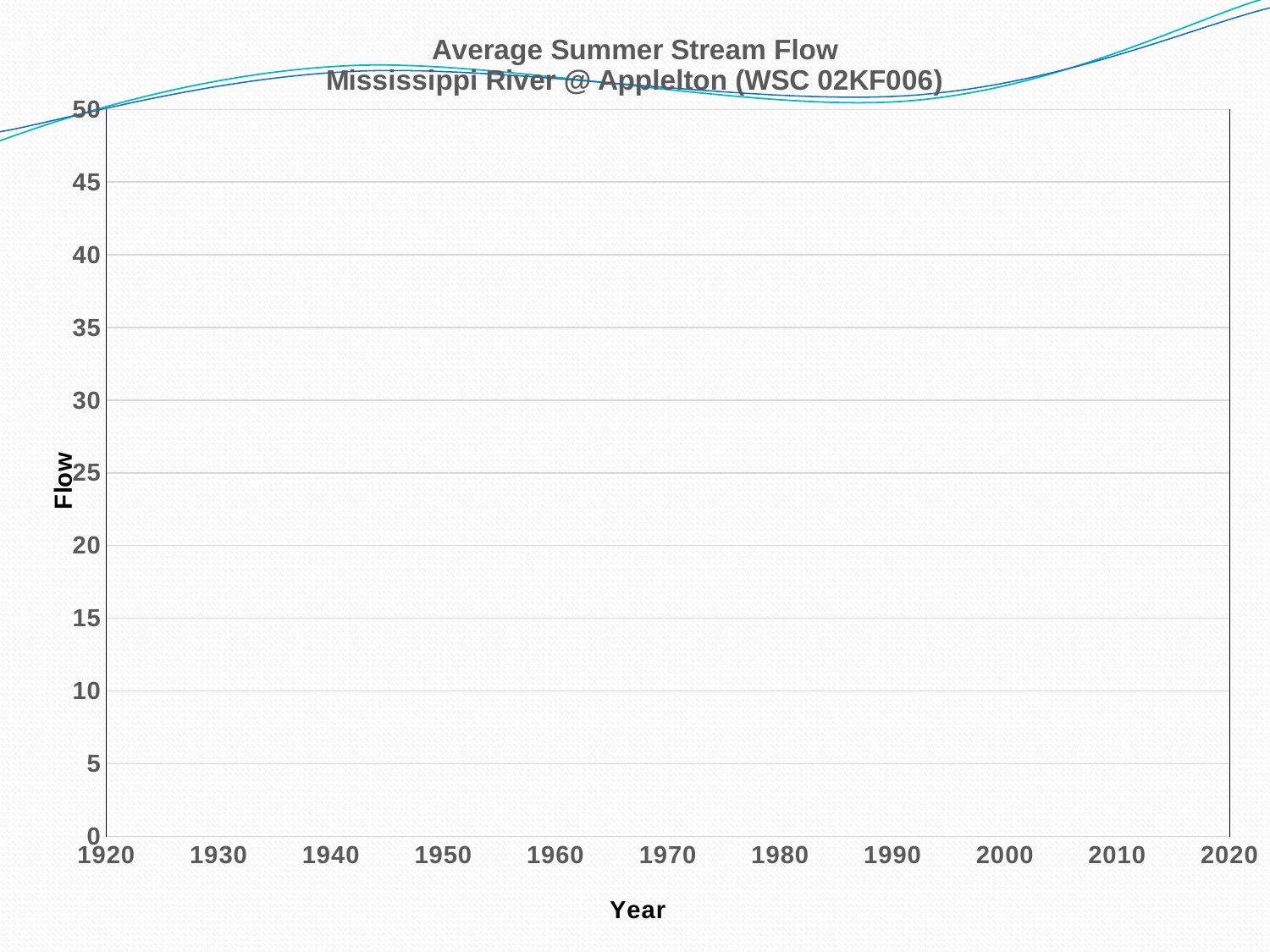
Do the plotted lines rise or fall between 1990 and 2020? rise How many lines are plotted on the chart? 2 How many year labels are shown along the x axis? 11 Is the plotted value around 1940 greater or less than 45? greater What is the title of the chart? Average Summer Stream Flow Mississippi River @ Applelton (WSC 02KF006) What is the label on the vertical axis of the chart? Flow Is the plotted value around 1990 greater or less than 40? greater Do the plotted lines rise or fall between 1950 and 1990? fall Is the plotted value around 2020 greater or less than 45? greater What kind of chart is shown on the slide? line chart Is the plotted value higher around 2020 or around 1990? 2020